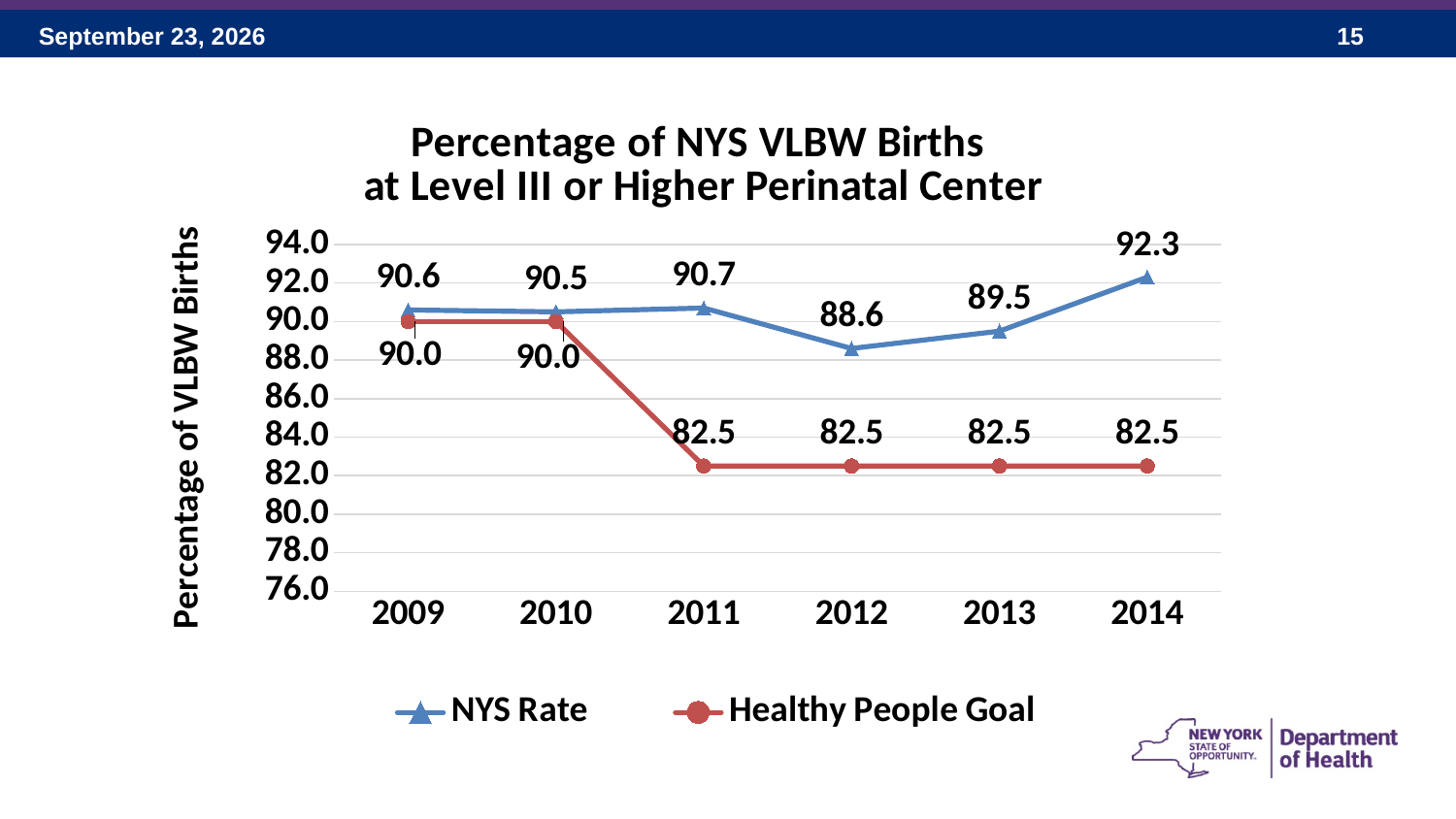
What is the NYS Rate in 2012? 88.6 What is the Healthy People Goal in 2011? 82.5 In which year is the NYS Rate lowest? 2012 Does the Healthy People Goal rise or fall from 2010 to 2011? Fall What is the title of the chart? Percentage of NYS VLBW Births at Level III or Higher Perinatal Center What kind of chart is this? Line chart In which year is the NYS Rate highest? 2014 Which is larger in 2013, the NYS Rate or the Healthy People Goal? NYS Rate How many years are shown on the x axis? 6 What is the NYS Rate in 2014? 92.3 How many series does the legend list? 2 What is the difference between the NYS Rate and the Healthy People Goal in 2014? 9.8